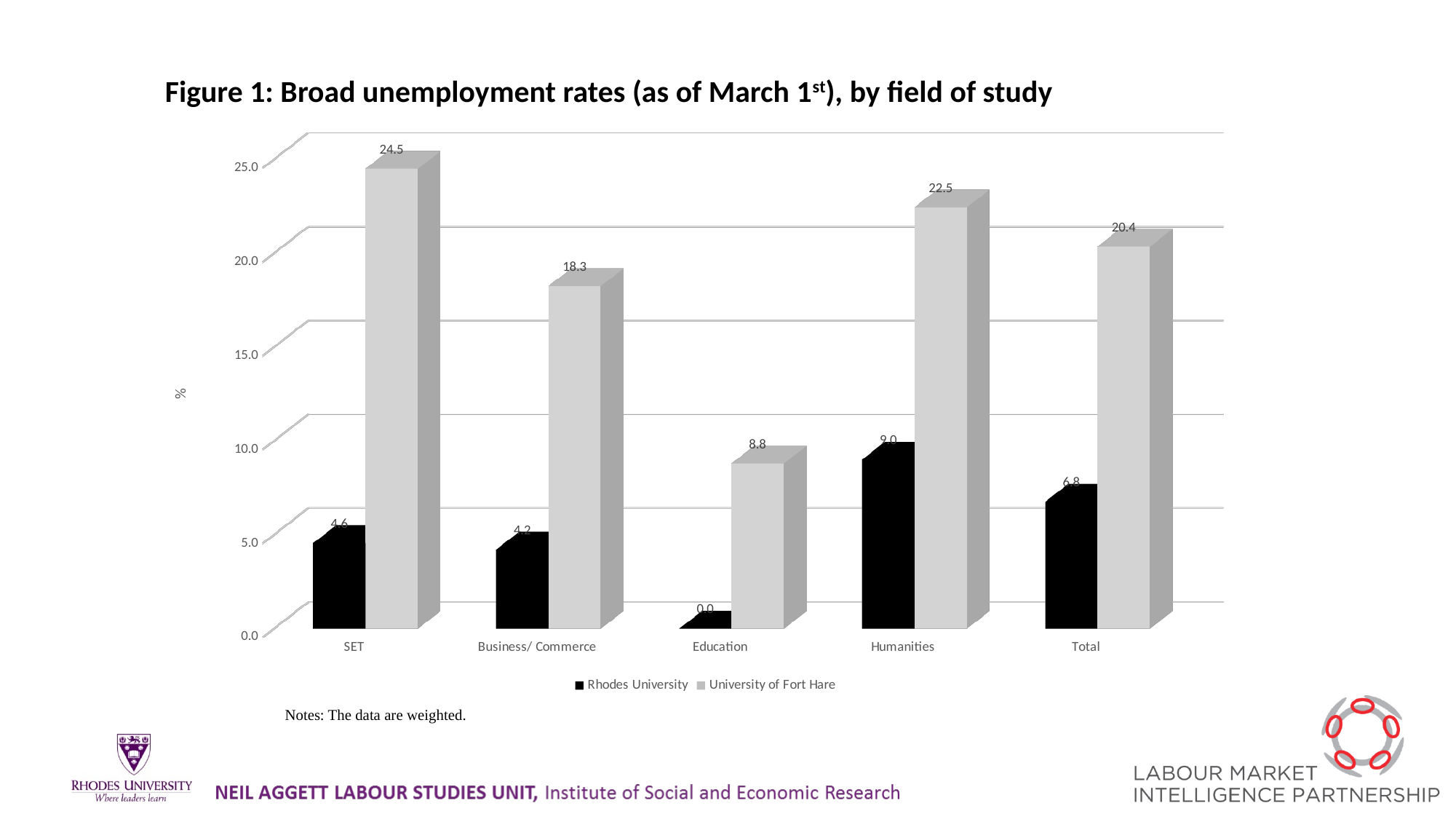
What kind of chart is shown on the slide? bar chart What is the broad unemployment rate for Rhodes University graduates in Education? 0.0 What is the difference between the University of Fort Hare and Rhodes University unemployment rates in Business/ Commerce? 14.1 How many series does the legend list? 2 Which is larger: the Rhodes University rate for Humanities or the Rhodes University rate for Total? Humanities Which field of study has the highest unemployment rate for University of Fort Hare? SET How many fields of study are shown on the x axis? 5 Which field of study has the lowest unemployment rate for Rhodes University? Education What is the Total broad unemployment rate for University of Fort Hare? 20.4 Is the University of Fort Hare value for Education greater or less than 10.0? less What is the broad unemployment rate for University of Fort Hare graduates in SET? 24.5 What is the broad unemployment rate for Rhodes University graduates in Humanities? 9.0